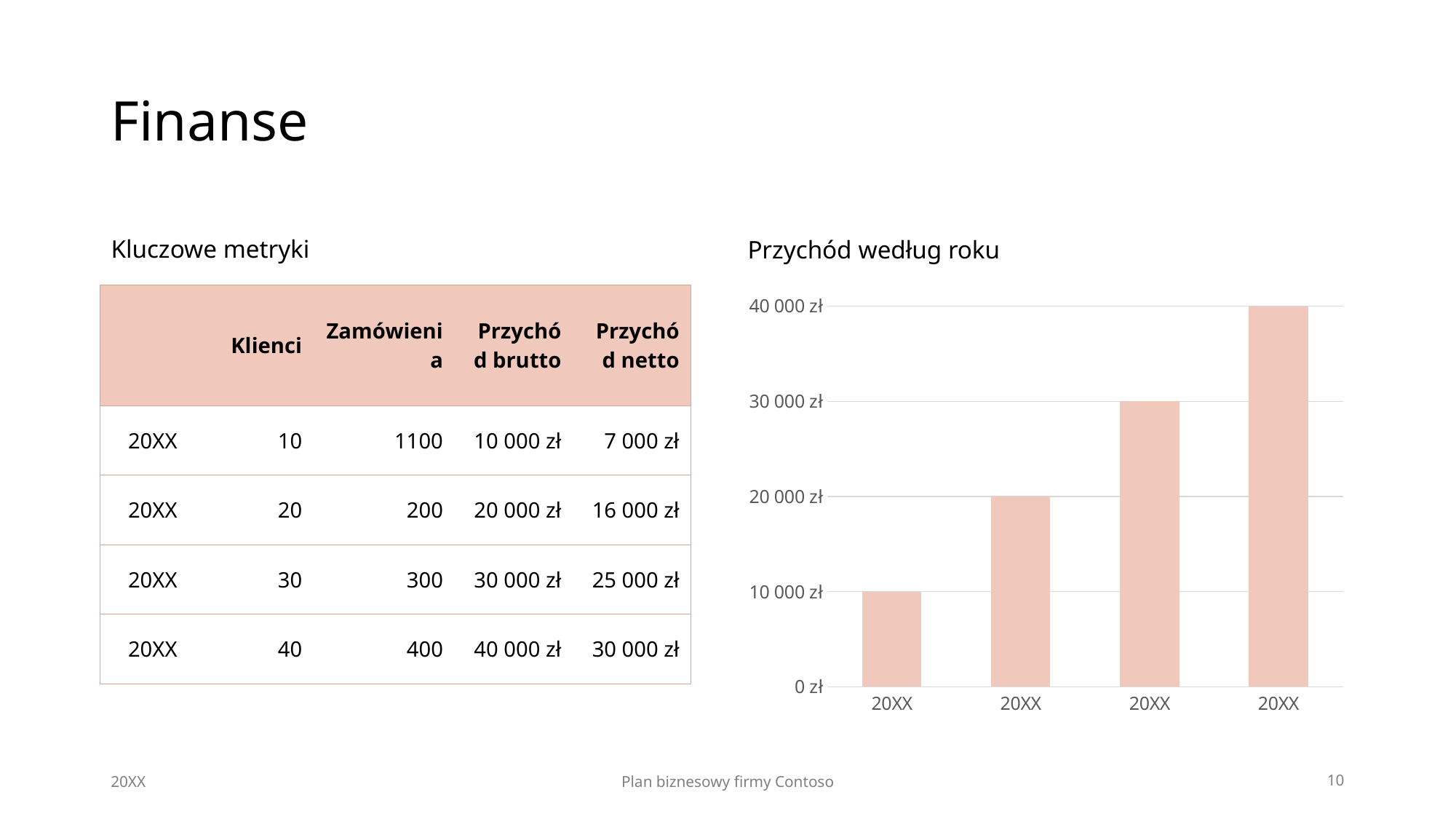
What is the value of the third bar from the left in the chart? 30 000 zł Which bar in the chart is the lowest? the leftmost (first) bar Which bar in the chart is the highest? the rightmost (fourth) bar What kind of chart is shown on the slide? bar chart What is the title of the chart on the slide? Przychód według roku What is the value of the rightmost bar in the chart? 40 000 zł How many bars does the chart show? 4 What is the highest value shown on the chart's vertical axis? 40 000 zł What is the value of the second bar from the left in the chart? 20 000 zł Do the values in the chart rise or fall from left to right? rise What is the value of the first (leftmost) bar in the chart? 10 000 zł What is the difference between the rightmost bar and the leftmost bar in the chart? 30 000 zł